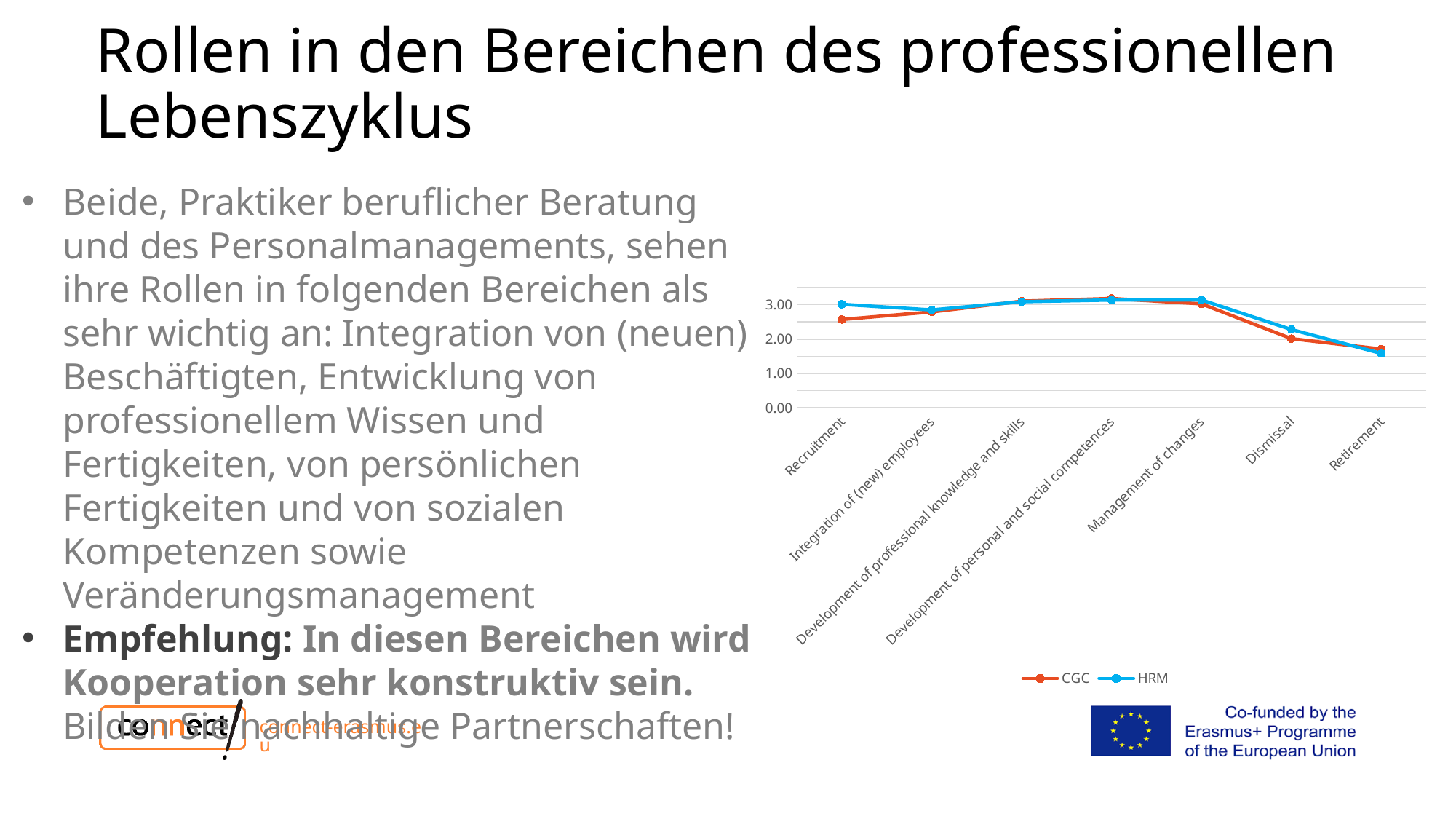
Is the CGC value for Recruitment greater or less than 3.00? less How many series does the chart legend list? 2 Is the CGC value for Retirement greater or less than 2.00? less For Dismissal, which series has the higher value, CGC or HRM? HRM Do the values rise or fall from Management of changes to Retirement? fall What kind of chart is shown on the slide? line chart What are the names of the two series in the chart legend? CGC and HRM Is the HRM value for Development of professional knowledge and skills greater or less than 2.00? greater For Recruitment, which series has the higher value, CGC or HRM? HRM How many categories are shown on the x axis of the chart? 7 Which category has the lowest value for the HRM series? Retirement